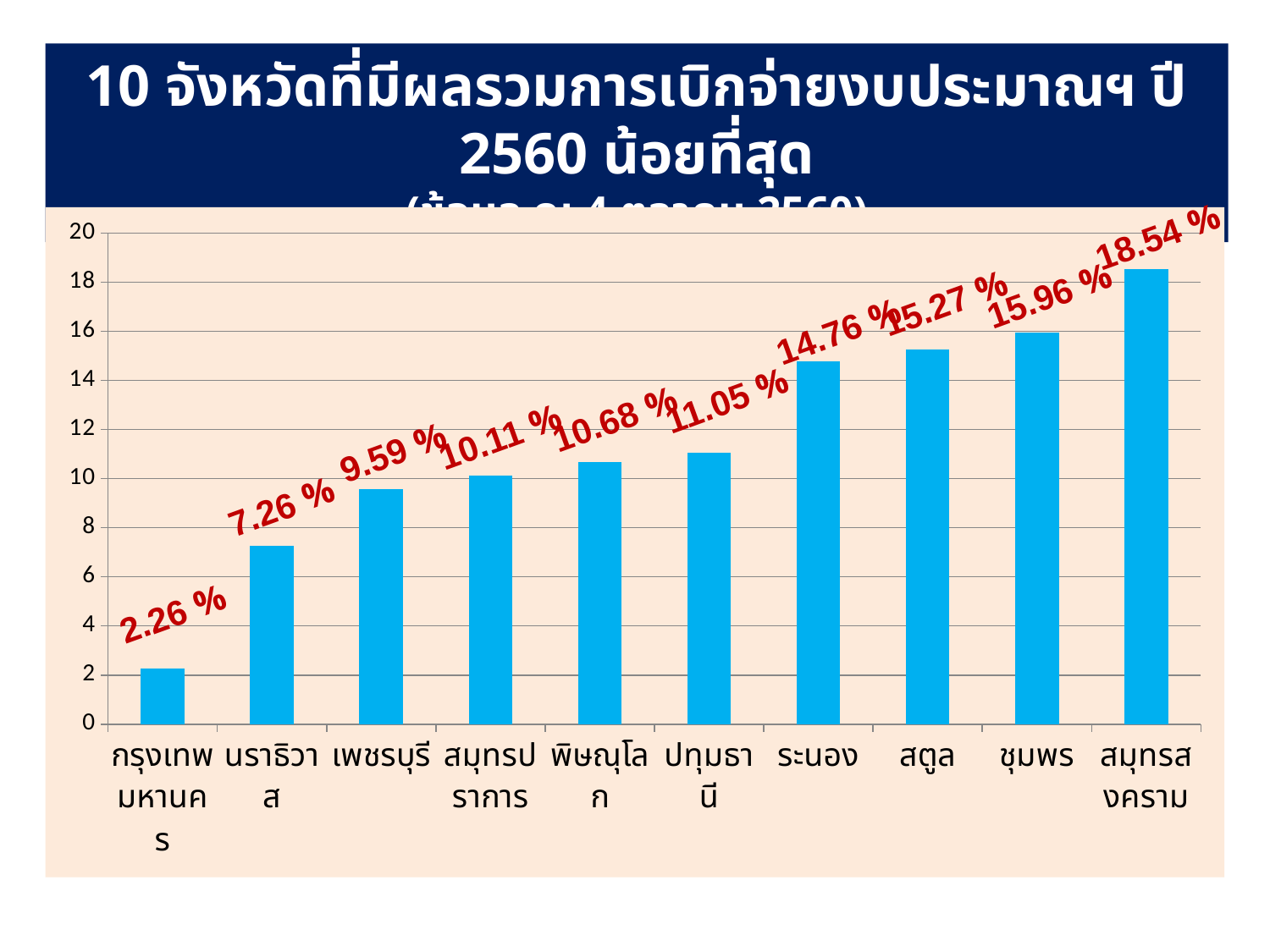
What kind of chart is shown on the slide? bar chart Is the value for ปทุมธานี greater or less than 12? less How many provinces are shown in the chart? 10 What is the difference between the values for ชุมพร and สตูล? 0.69 % What is the difference between the values for สมุทรสงคราม and กรุงเทพมหานคร? 16.28 % What is the value for กรุงเทพมหานคร? 2.26 % What is the value for ระนอง? 14.76 % Which is larger, the value for นราธิวาส or the value for เพชรบุรี? เพชรบุรี Which province has the highest value? สมุทรสงคราม What is the value for พิษณุโลก? 10.68 % Do the values rise or fall from left to right along the x axis? rise Which province has the lowest value? กรุงเทพมหานคร